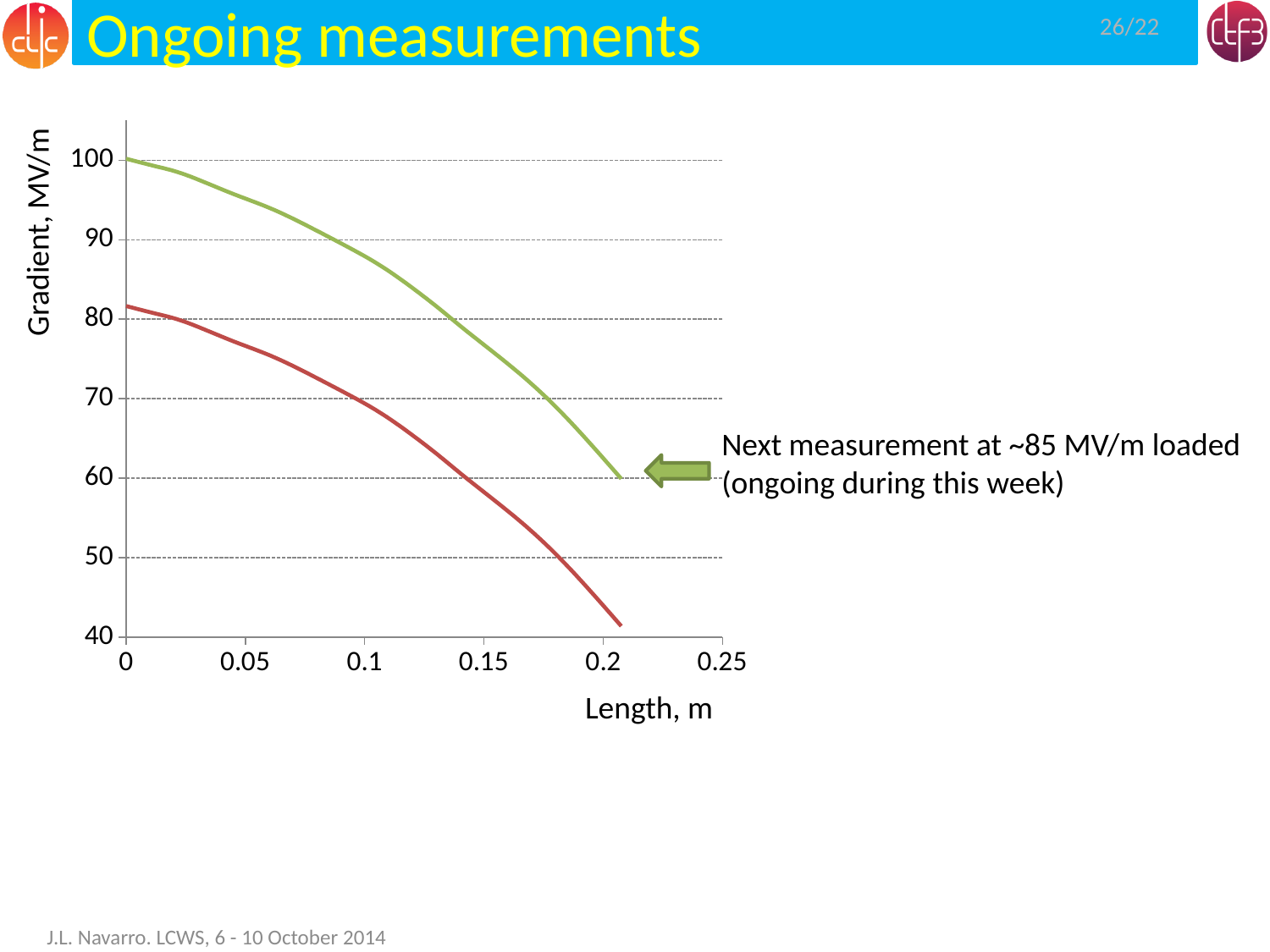
What is the label of the horizontal axis? Length, m Is the gradient of the red line at length 0 m greater or less than 90? less Is the gradient of the green line at length 0.15 m greater or less than 70? greater What kind of chart is shown on the slide? line chart Is the gradient of the green line at length 0.05 m greater or less than 90? greater What is the label of the vertical axis? Gradient, MV/m How many lines are plotted on the chart? 2 Do the plotted gradient values rise or fall as length increases? fall Which line has the higher gradient at length 0.1 m, the green line or the red line? green line What is the gradient of the green line at length 0 m? 100